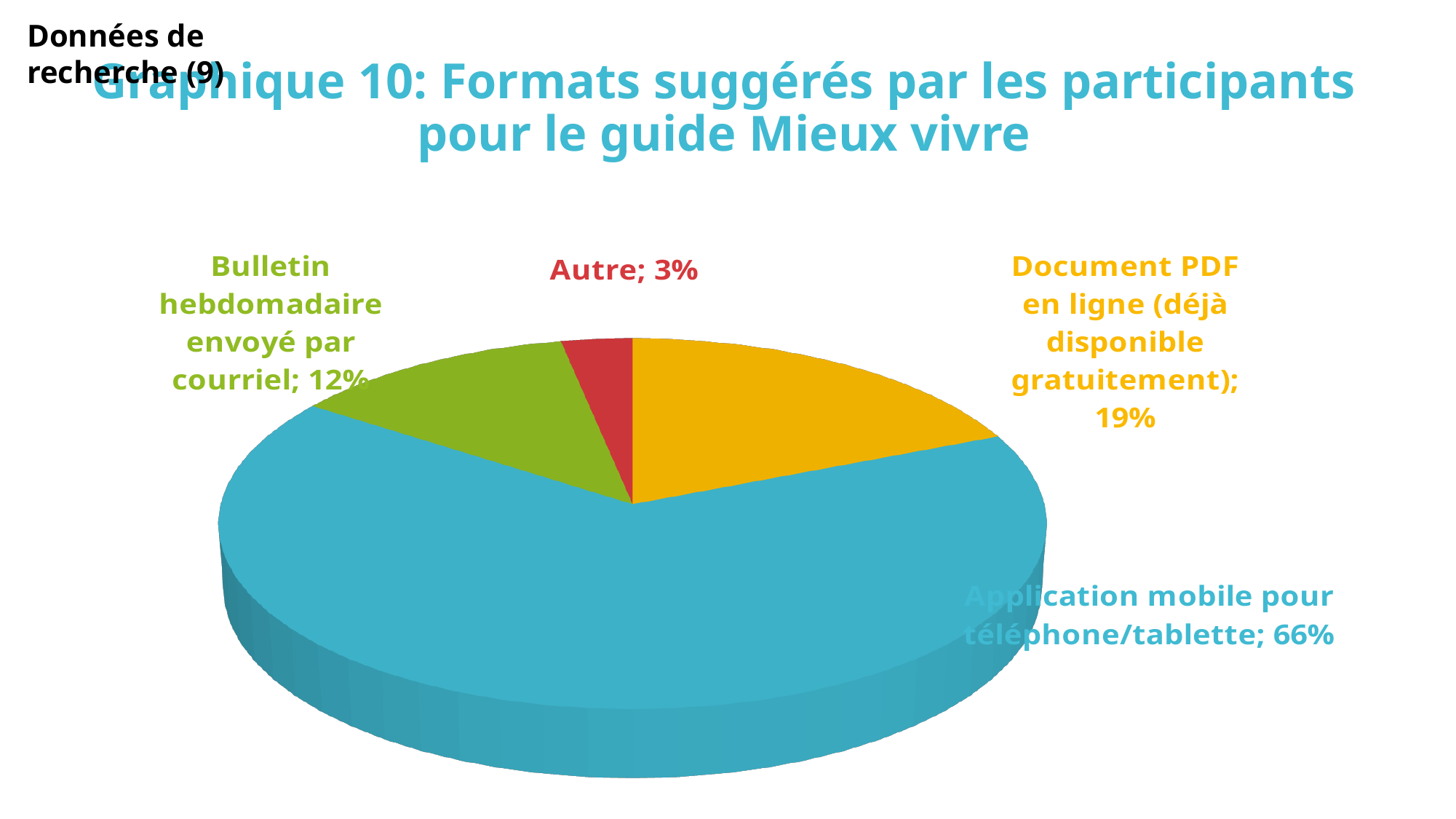
What share of the pie is labelled 'Application mobile pour téléphone/tablette'? 66% Which format has the largest share of the pie? Application mobile pour téléphone/tablette What is the difference in percentage points between 'Application mobile pour téléphone/tablette' and 'Document PDF en ligne (déjà disponible gratuitement)'? 47 percentage points What share of the pie is labelled 'Bulletin hebdomadaire envoyé par courriel'? 12% What kind of chart is shown on the slide? Pie chart Which is larger: the share for 'Bulletin hebdomadaire envoyé par courriel' or the share for 'Document PDF en ligne (déjà disponible gratuitement)'? Document PDF en ligne (déjà disponible gratuitement) What is the title of the chart? Graphique 10: Formats suggérés par les participants pour le guide Mieux vivre What share of the pie is labelled 'Autre'? 3% What colour is the slice for 'Autre'? Red Which format has the smallest share of the pie? Autre How many slices does the pie chart have? 4